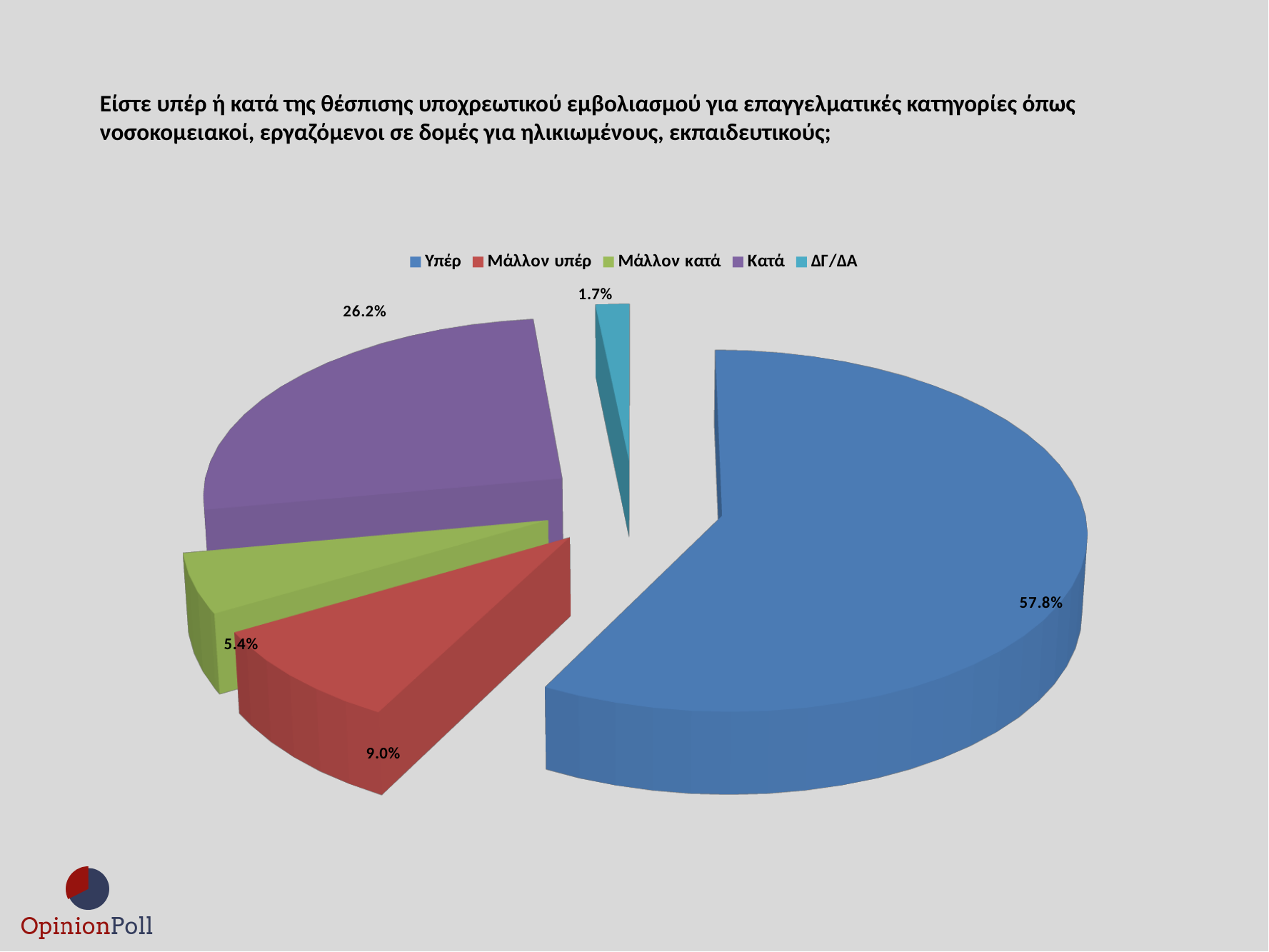
How many categories does the legend list? 5 What colour is the slice for Κατά? Purple What percentage is shown for Κατά? 26.2% What percentage is shown for Υπέρ? 57.8% What percentage is shown for Μάλλον κατά? 5.4% Which category has the largest slice of the pie? Υπέρ What percentage is shown for ΔΓ/ΔΑ? 1.7% What kind of chart is shown on the slide? Pie chart Which is larger, Μάλλον υπέρ or Μάλλον κατά? Μάλλον υπέρ What is the difference in percentage points between Υπέρ and Κατά? 31.6 What percentage is shown for Μάλλον υπέρ? 9.0% Which category has the smallest slice of the pie? ΔΓ/ΔΑ